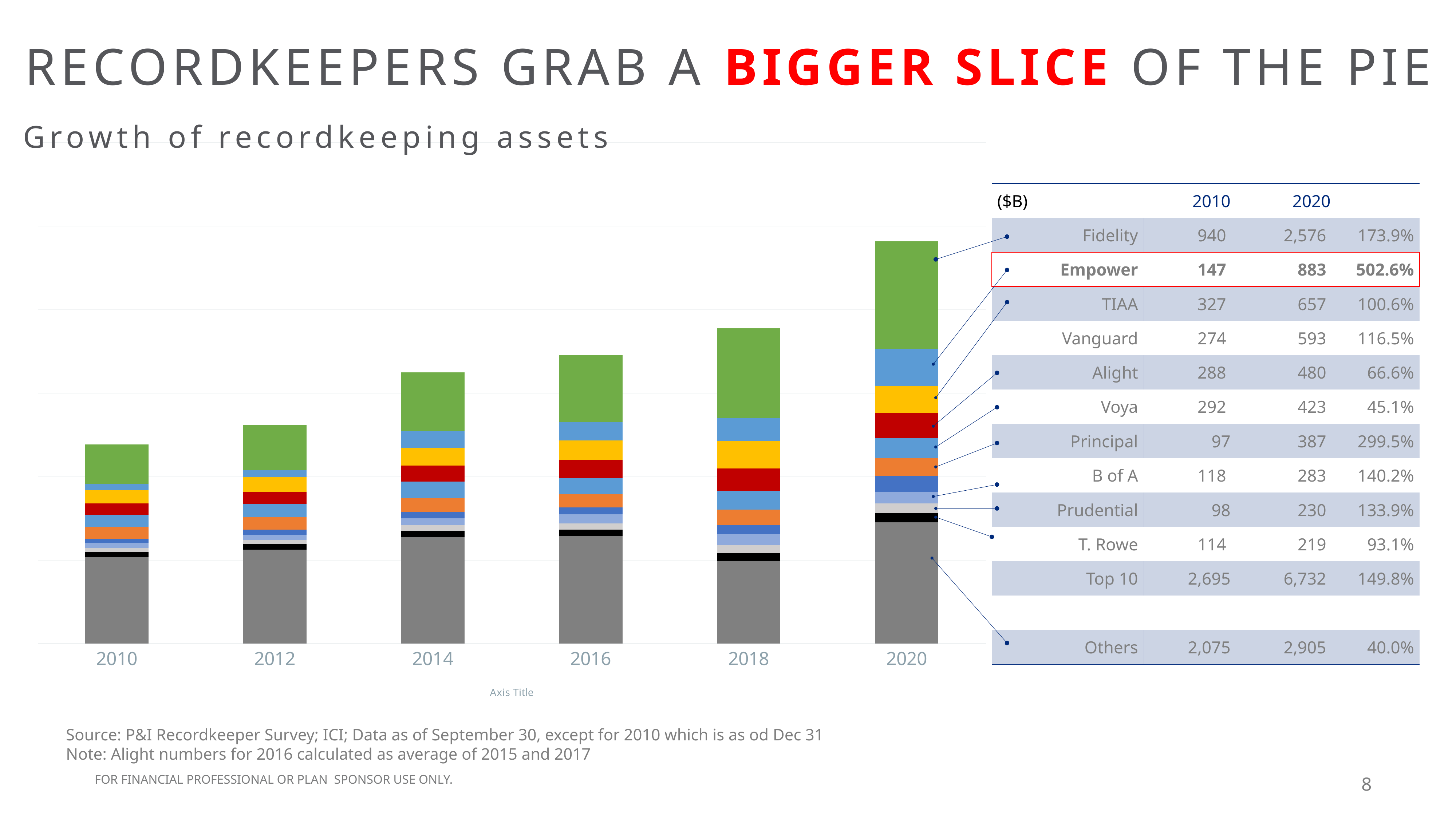
Do the total bar heights rise or fall from 2010 to 2020? Rise Which year has the shortest stacked bar? 2010 How many years are shown along the x axis of the chart? 6 According to the table, what was Empower's value ($B) in 2010? 147 Which year has the tallest stacked bar? 2020 What kind of chart is shown on the slide? Stacked bar chart What growth percentage does the table show for Others? 40.0% According to the table, what is the Top 10 value ($B) for 2020? 6,732 By how much did Empower's value ($B) increase from 2010 to 2020 according to the table? 736 According to the table linked to the 2020 bar, what is Fidelity's 2020 value ($B)? 2,576 What text appears as the x-axis title below the chart? Axis Title Which bar is taller, 2016 or 2018? 2018